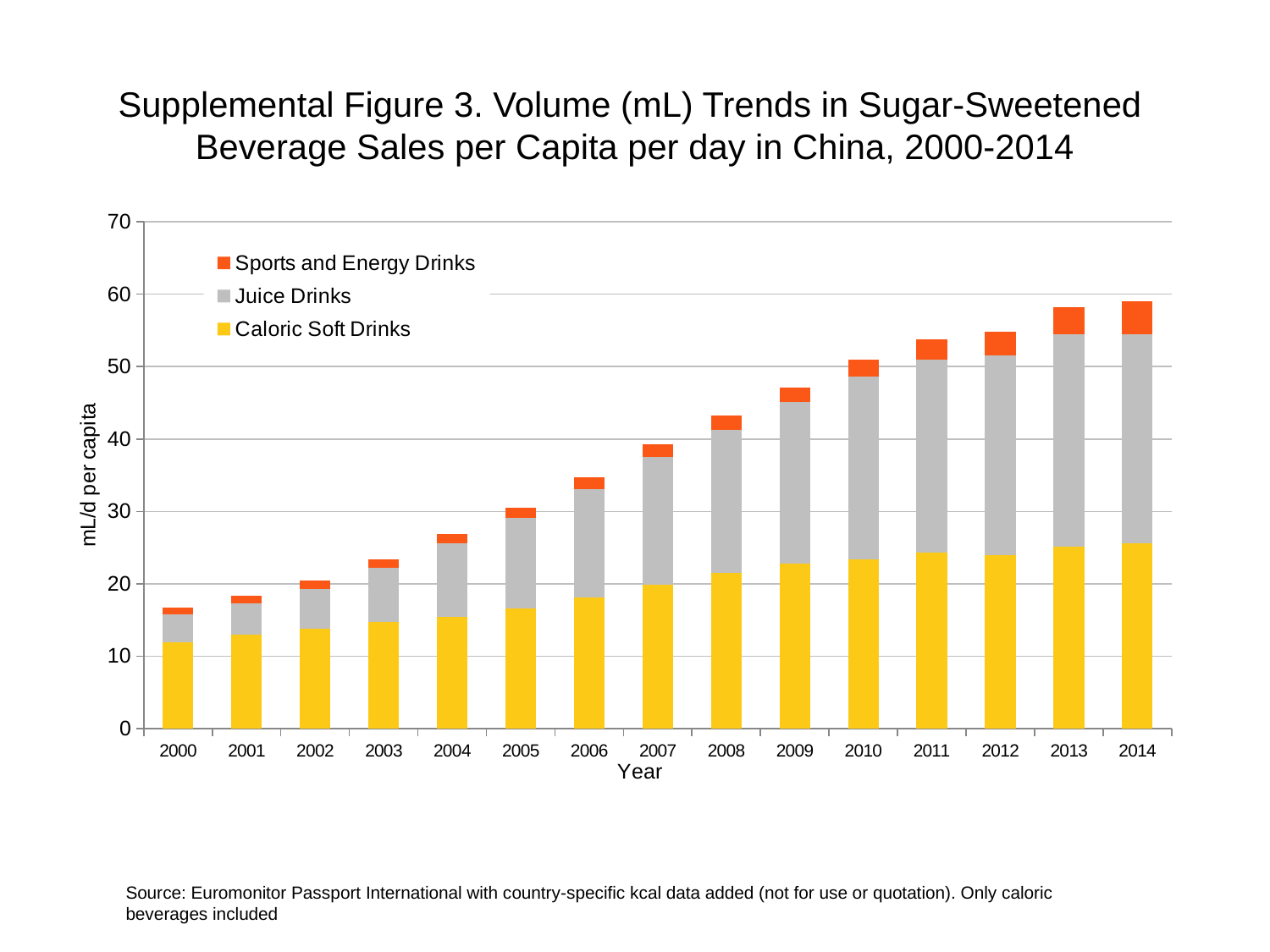
Is the Caloric Soft Drinks value for 2014 greater or less than 20? greater How many series does the legend list? 3 Which year has the highest total sugar-sweetened beverage volume? 2014 Which series is shown in orange in the legend? Sports and Energy Drinks Is the total value for 2014 greater or less than 50? greater What kind of chart is shown on the slide? Stacked bar chart What is the label on the y axis? mL/d per capita Is the total value for 2005 greater or less than 40? less Do the total bar heights rise or fall from 2000 to 2014? Rise How many years are shown along the x axis? 15 Which year has the lowest total sugar-sweetened beverage volume? 2000